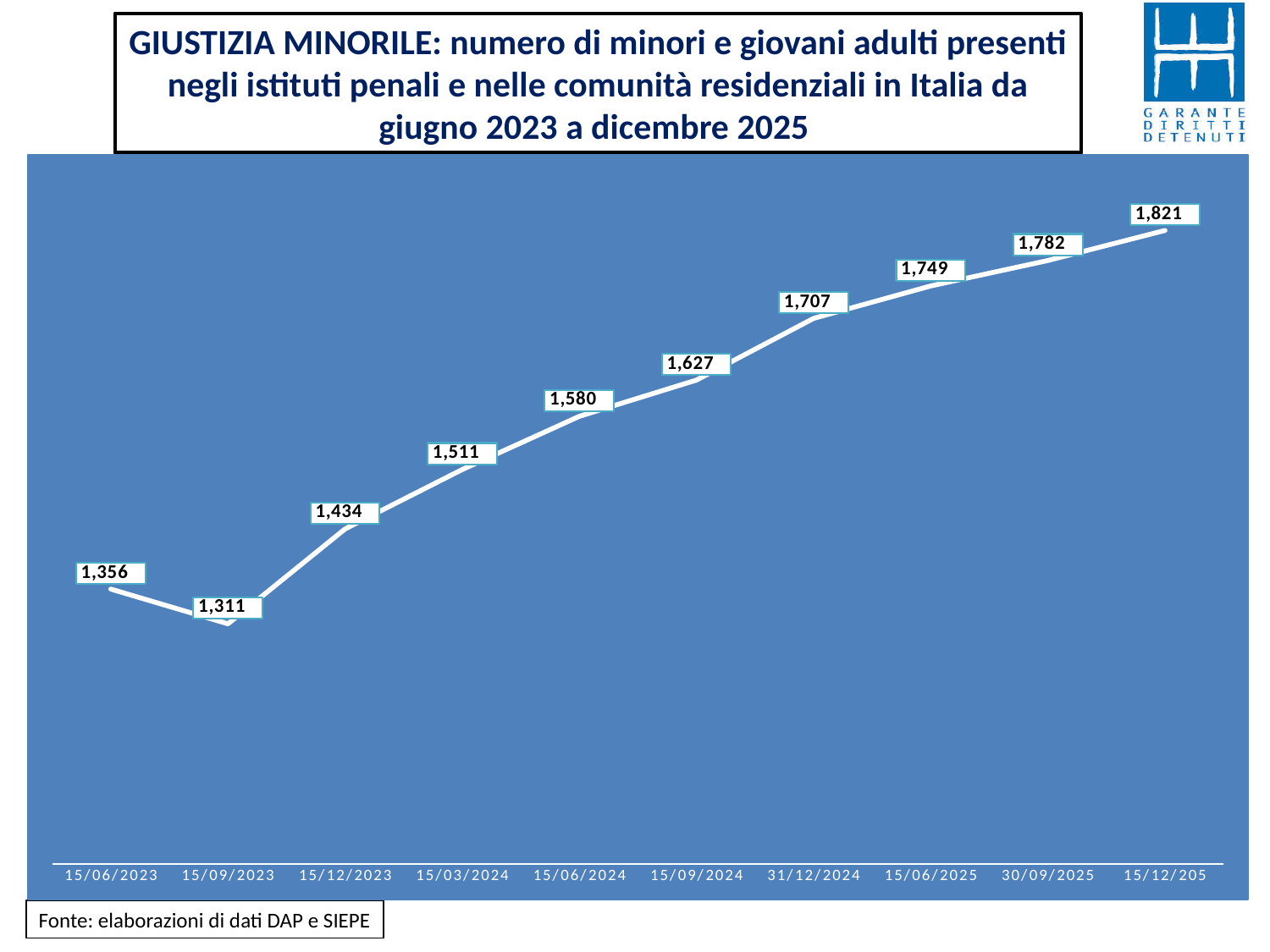
What is the value for 15/06/2024? 1,580 What is the value for 15/09/2023? 1,311 How many data points are plotted on the chart? 10 What is the value for 31/12/2024? 1,707 What kind of chart is shown on the slide? line chart What is the value for 15/06/2023? 1,356 Which date has the lowest value? 15/09/2023 What is the difference between the values for 15/12/2023 and 15/09/2023? 123 Do the values generally rise or fall from 15/09/2023 to 15/12/205? rise Which is larger, the value for 15/03/2024 or the value for 15/09/2024? 15/09/2024 What is the difference between the values for 15/12/205 and 15/06/2023? 465 Which date has the highest value? 15/12/205